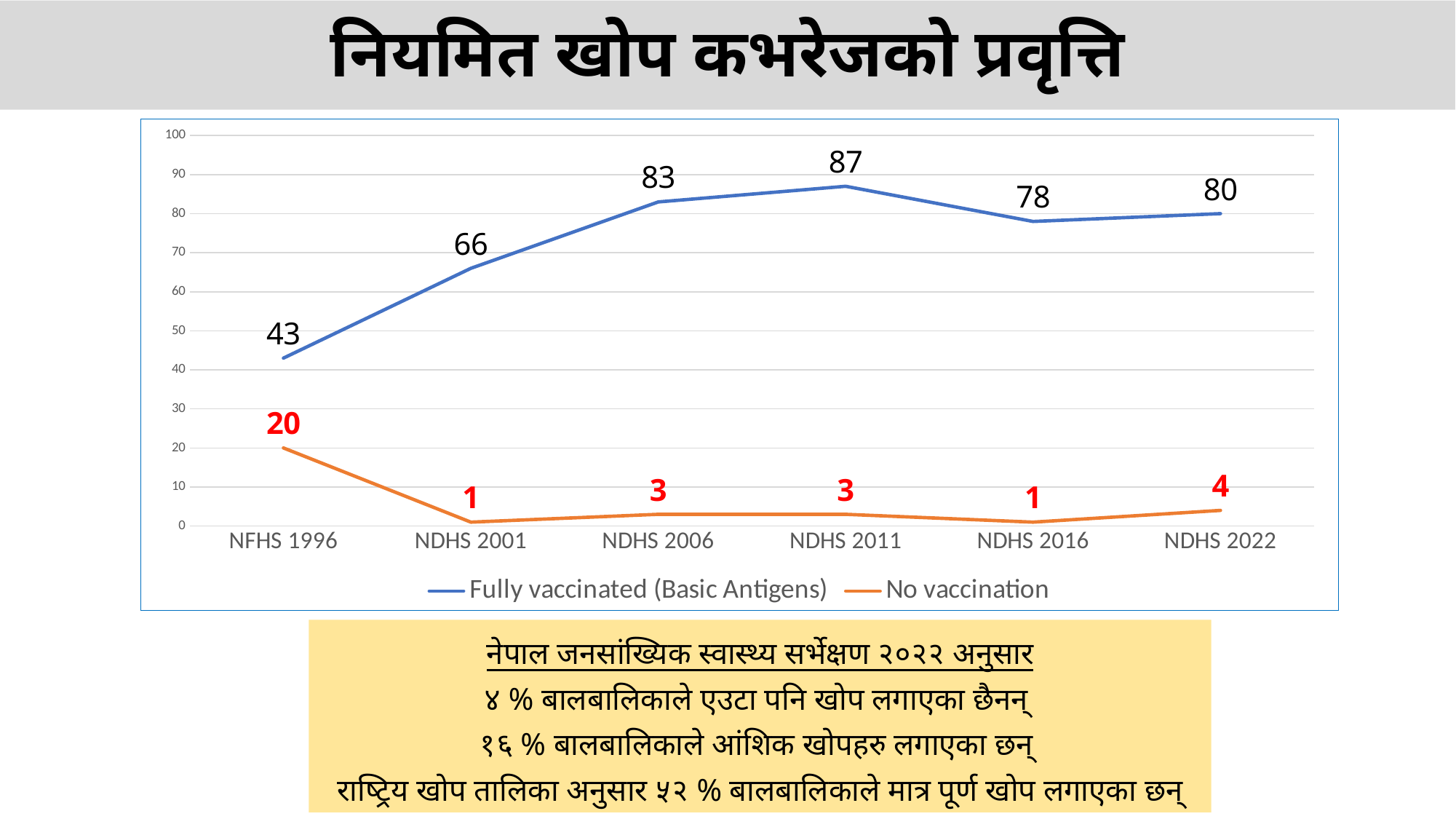
Does the No vaccination series rise or fall from NFHS 1996 to NDHS 2001? Fall What is the value for Fully vaccinated (Basic Antigens) at NDHS 2022? 80 Which is larger: the Fully vaccinated (Basic Antigens) value at NDHS 2006 or at NDHS 2022? NDHS 2006 In which survey is the Fully vaccinated (Basic Antigens) value highest? NDHS 2011 What is the value for No vaccination at NFHS 1996? 20 How many survey points are plotted on the x axis? 6 What is the value for Fully vaccinated (Basic Antigens) at NDHS 2011? 87 In which survey is the Fully vaccinated (Basic Antigens) value lowest? NFHS 1996 What kind of chart is shown on the slide? Line chart Is the Fully vaccinated (Basic Antigens) value at NDHS 2001 greater or less than 60? greater What is the difference between the Fully vaccinated (Basic Antigens) values at NDHS 2011 and NDHS 2016? 9 How many series does the legend list? 2